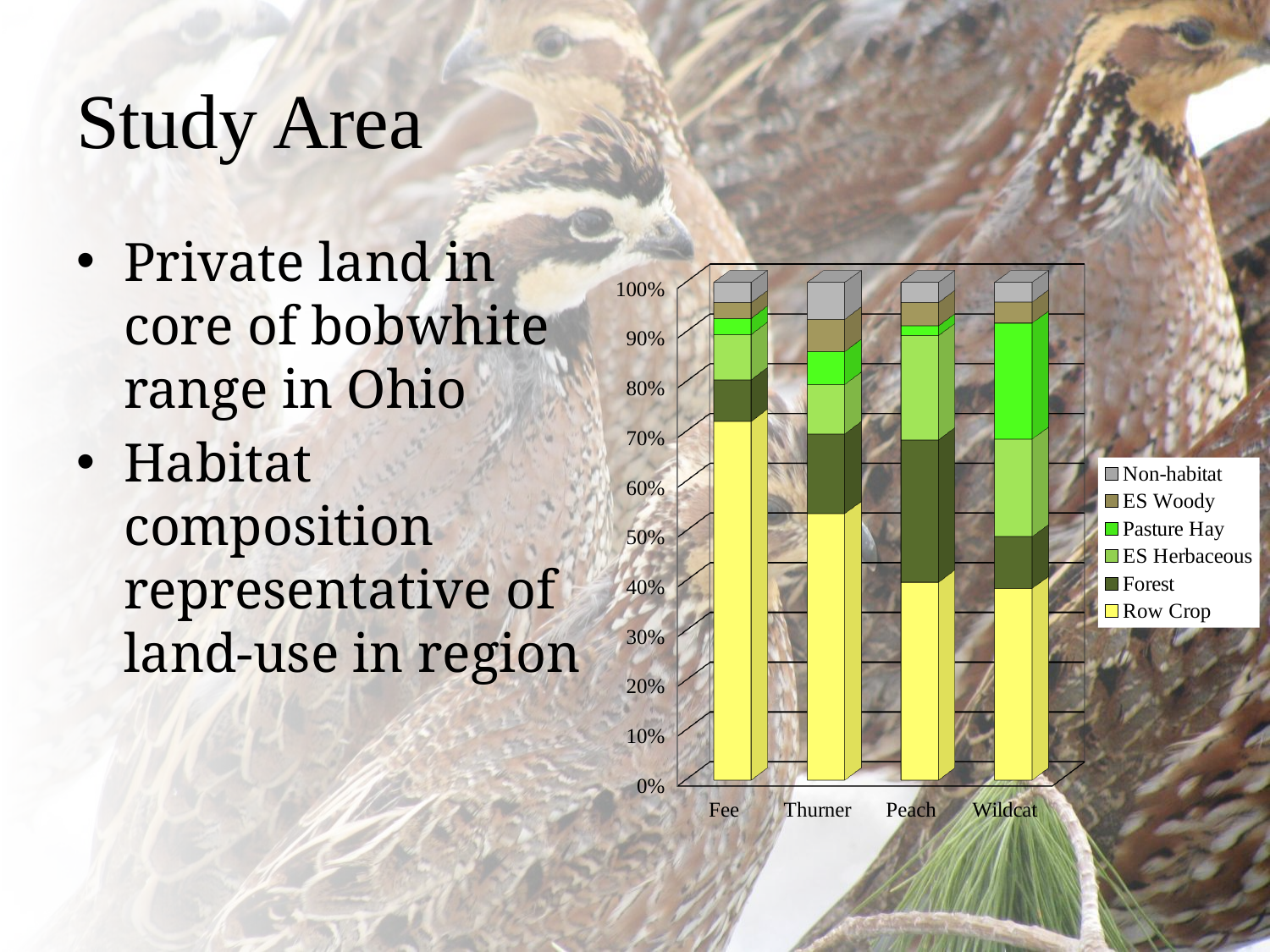
Which site has the largest Forest share? Peach How many series does the chart's legend list? 6 Is the Row Crop share for Peach greater or less than 50%? less Which site has a larger Row Crop share, Thurner or Peach? Thurner Is the Row Crop share for Wildcat greater or less than 50%? less Is the Row Crop share for Fee greater or less than 60%? greater How many categories (sites) are shown on the x axis of the chart? 4 What kind of chart is shown on the slide? Stacked bar chart Which site has a larger Forest share, Fee or Peach? Peach Which series is listed first (at the top) in the chart's legend? Non-habitat Which site has the largest Pasture Hay share? Wildcat Which site has the largest Row Crop share? Fee